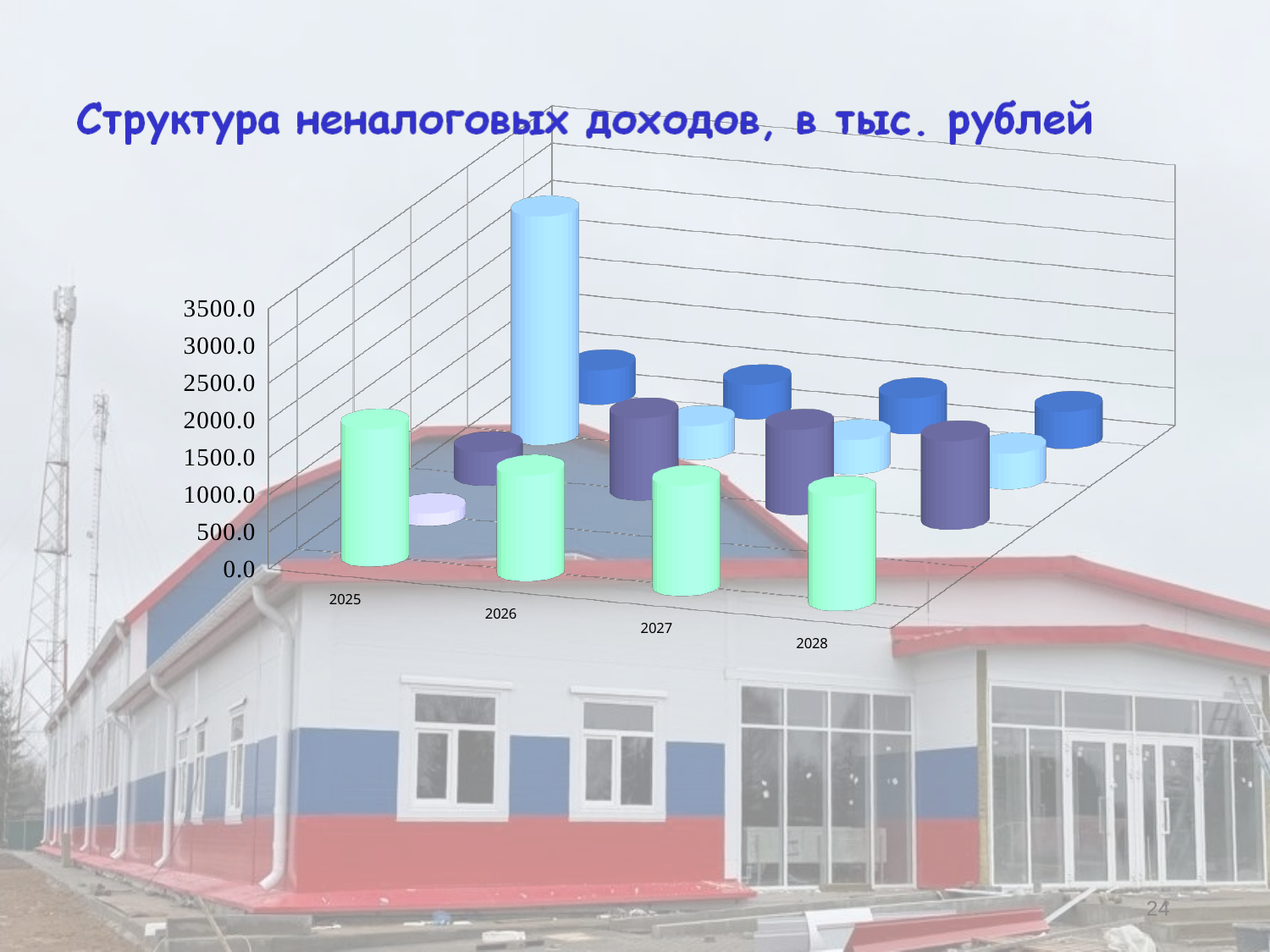
In which year is the tallest bar of the whole chart found? 2025 How many years are shown along the x axis of the chart? 4 Which year has the tallest green (front row) bar? 2025 Which is larger, the green (front row) bar for 2025 or the green bar for 2028? 2025 Is the small light purple bar for 2025 greater or less than 500? less Is the green (front row) bar for 2025 greater or less than 1000? greater What is the highest value labelled on the vertical axis of the chart? 3500.0 What is the title of the chart? Структура неналоговых доходов, в тыс. рублей What kind of chart is shown on the slide? bar chart